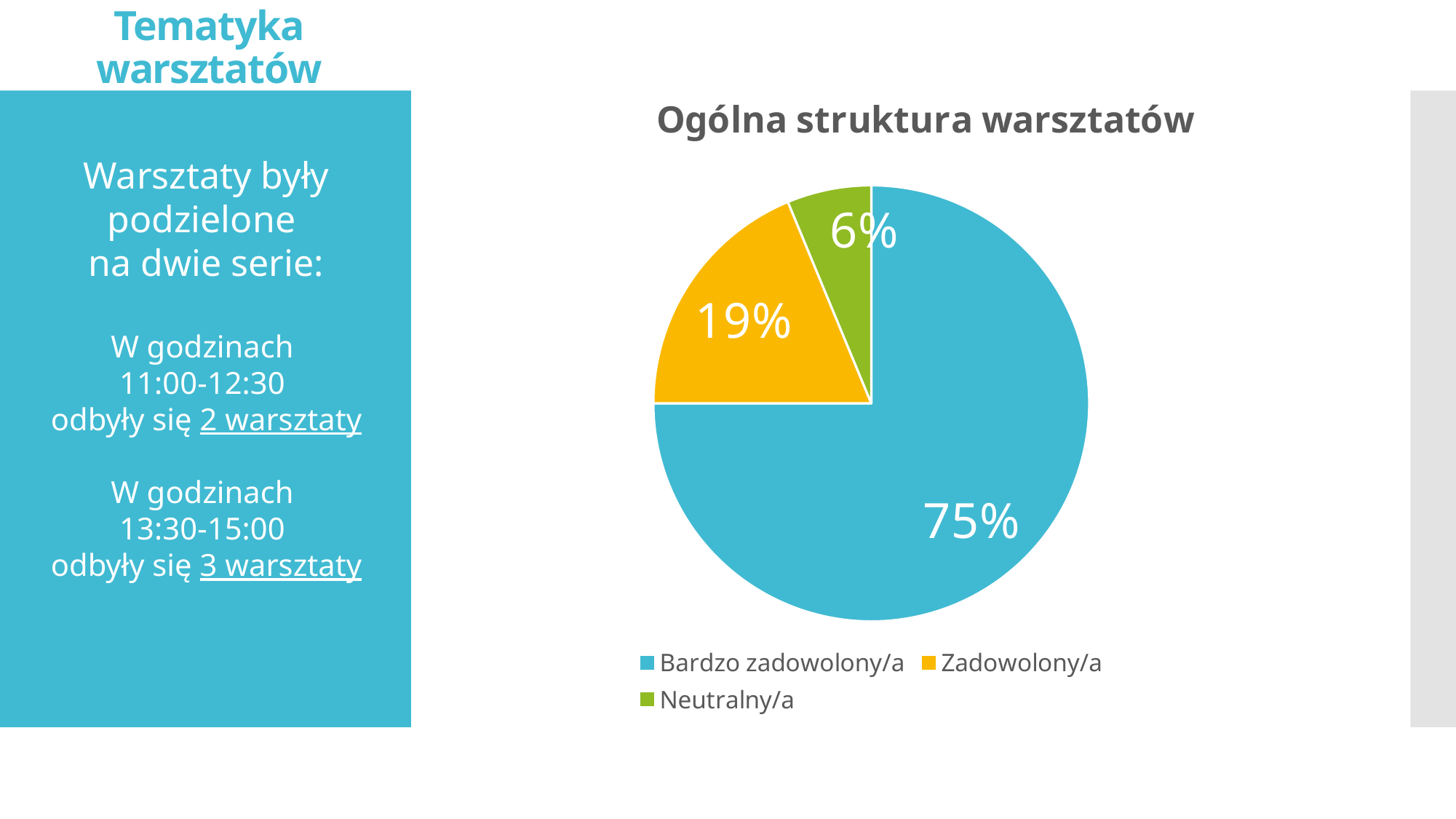
Which slice is larger: "Zadowolony/a" or "Neutralny/a"? Zadowolony/a How many categories does the pie chart show? 3 What kind of chart is shown on the slide? pie chart What share of the pie is labelled "Neutralny/a"? 6% What is the difference in percentage points between the "Bardzo zadowolony/a" and "Zadowolony/a" slices? 56 What is the title of the chart? Ogólna struktura warsztatów What share of the pie is labelled "Bardzo zadowolony/a"? 75% What share of the pie is labelled "Zadowolony/a"? 19% Which category has the largest slice of the pie? Bardzo zadowolony/a Which category has the smallest slice of the pie? Neutralny/a What colour is the "Neutralny/a" slice? green What is the difference in percentage points between the "Zadowolony/a" and "Neutralny/a" slices? 13